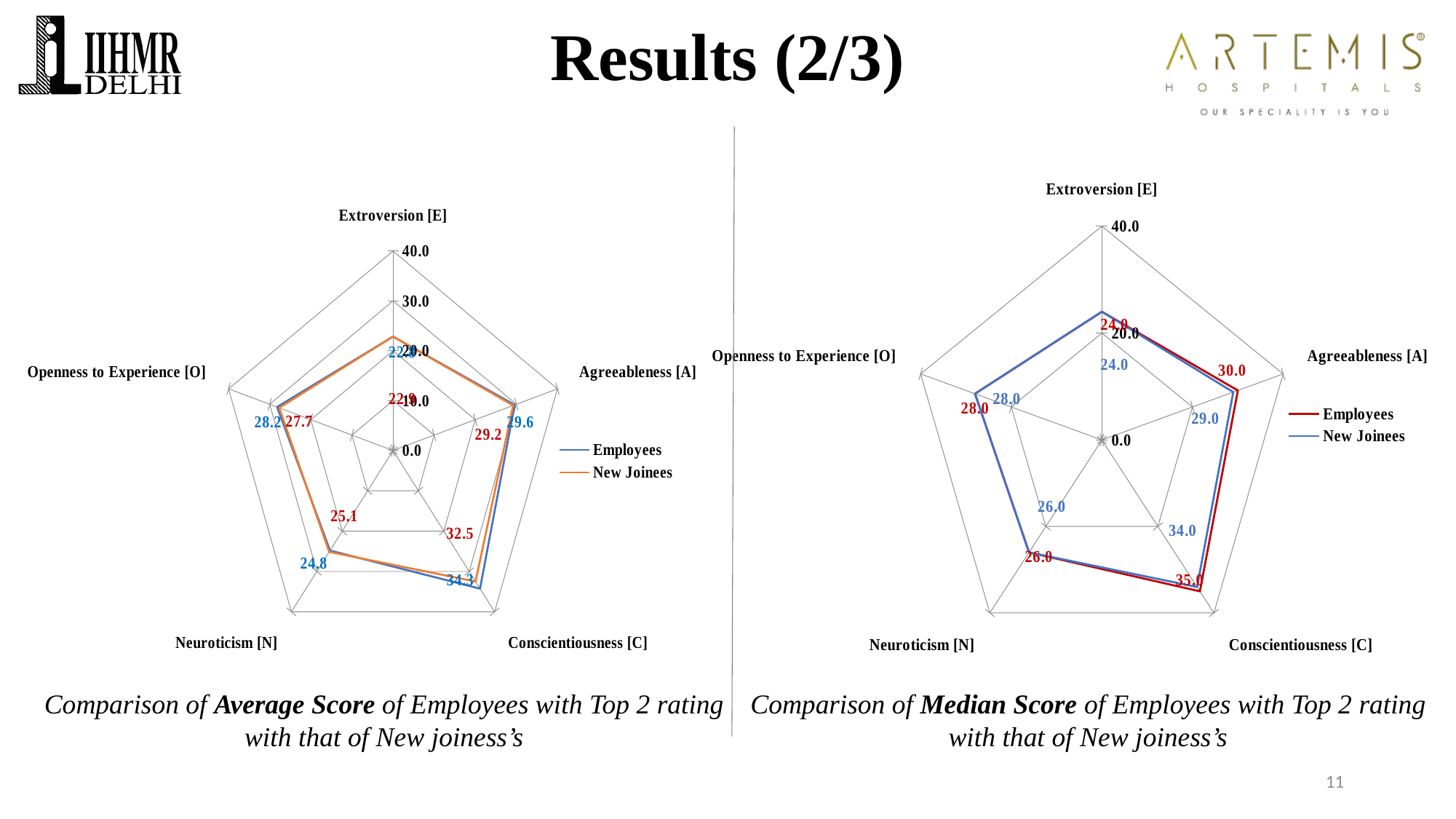
In the Average Score chart on the left, what is the difference between the Employees and New Joinees values for Agreeableness [A]? 0.4 In the Median Score chart on the right, what is the difference between the Employees and New Joinees values for Conscientiousness [C]? 1.0 In the Median Score chart on the right, what is the New Joinees value for Conscientiousness [C]? 34.0 In the Average Score chart on the left, which is larger for Neuroticism [N]: the Employees value or the New Joinees value? New Joinees In the Average Score chart on the left, what is the Employees value for Conscientiousness [C]? 34.3 In the Median Score chart on the right, what is the Employees value for Agreeableness [A]? 30.0 In the Average Score chart on the left, what is the New Joinees value for Neuroticism [N]? 25.1 What kind of chart is the Average Score chart on the left? Radar chart In the Median Score chart on the right, which trait has the lowest Employees value? Extroversion [E] How many series does the legend of the Median Score chart on the right list? 2 In the Average Score chart on the left, what is the New Joinees value for Openness to Experience [O]? 27.7 In the Average Score chart on the left, which trait has the highest Employees value? Conscientiousness [C]